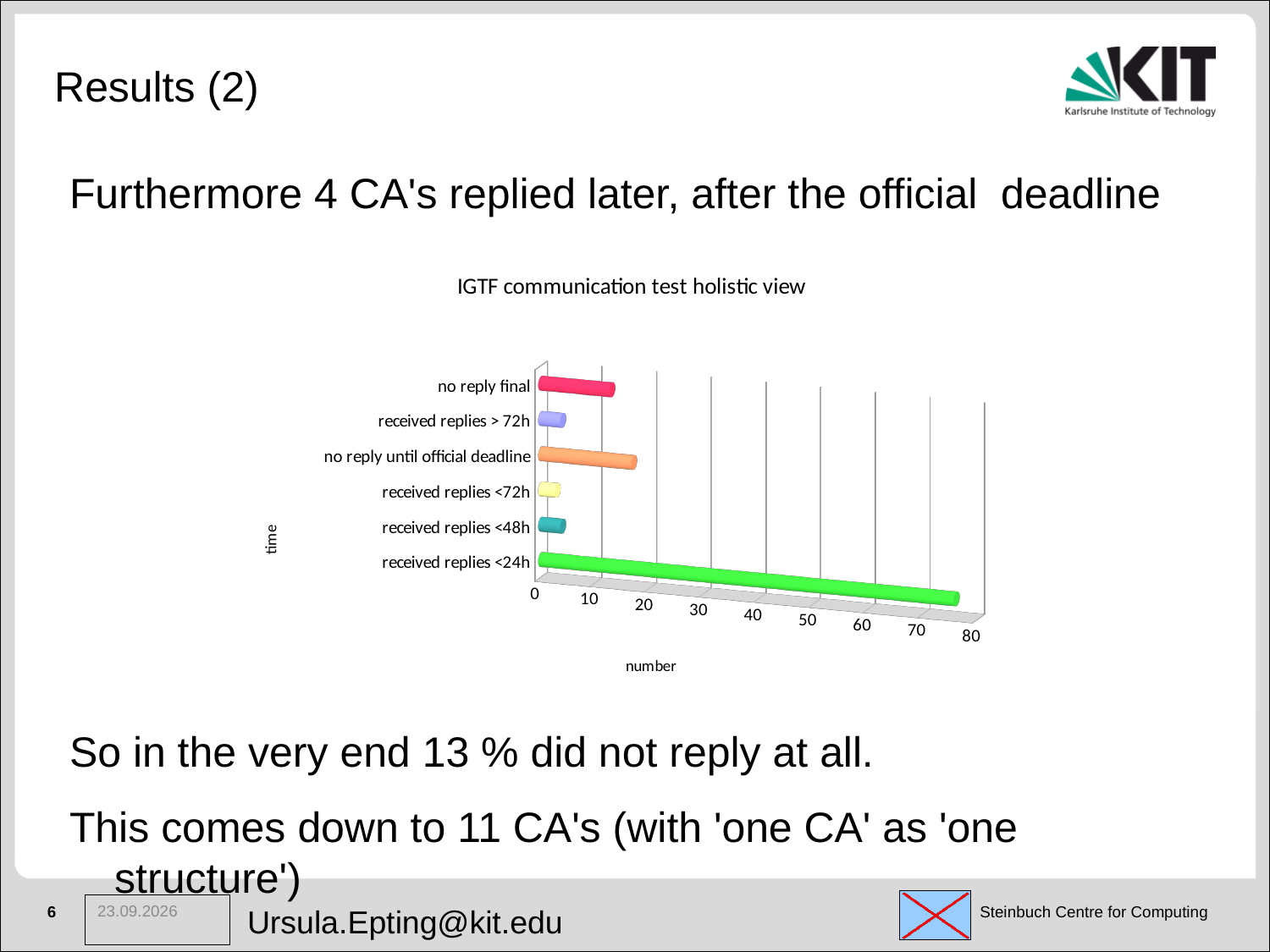
What kind of chart is shown on the slide? bar chart What is the label of the horizontal (value) axis of the chart? number How many categories are plotted in the chart? 6 Is the value for 'received replies <24h' greater or less than 70? greater Which is larger, the value for 'no reply until official deadline' or the value for 'received replies <48h'? no reply until official deadline What is the title of the chart? IGTF communication test holistic view Which is larger, the value for 'received replies <24h' or the value for 'no reply final'? received replies <24h Is the value for 'received replies > 72h' greater or less than 10? less Is the value for 'no reply until official deadline' greater or less than 10? greater Which category has the highest value in the chart? received replies <24h